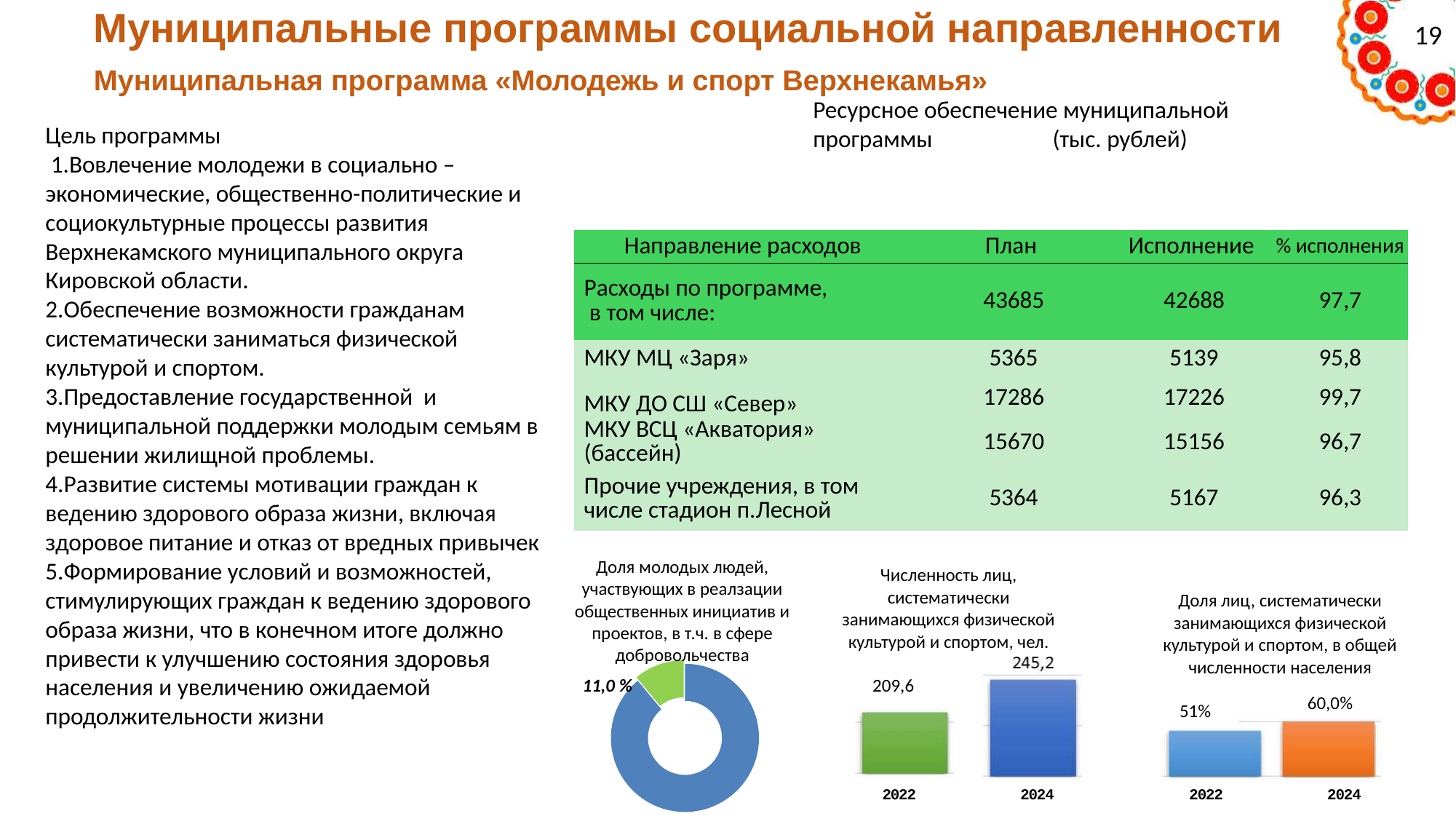
In the chart titled «Численность лиц, систематически занимающихся физической культурой и спортом, чел.», what is the value for 2022? 209,6 In the chart titled «Доля лиц, систематически занимающихся физической культурой и спортом, в общей численности населения», what is the value for 2024? 60,0% In the chart titled «Доля лиц, систематически занимающихся физической культурой и спортом, в общей численности населения», what is the value for 2022? 51% In the chart titled «Численность лиц, систематически занимающихся физической культурой и спортом, чел.», what is the value for 2024? 245,2 In the chart titled «Численность лиц, систематически занимающихся физической культурой и спортом, чел.», do the values rise or fall from 2022 to 2024? rise In the doughnut chart at the bottom left of the slide, what share is shown by the labelled green slice? 11,0 % In the chart titled «Доля лиц, систематически занимающихся физической культурой и спортом, в общей численности населения», which year has the lower value? 2022 In the chart titled «Доля лиц, систематически занимающихся физической культурой и спортом, в общей численности населения», how many years are shown? 2 What kind of chart is the one at the bottom left of the slide, titled «Доля молодых людей, участвующих в реализации общественных инициатив и проектов, в т.ч. в сфере добровольчества»? doughnut chart What kind of chart is the one titled «Численность лиц, систематически занимающихся физической культурой и спортом, чел.»? bar chart In the chart titled «Численность лиц, систематически занимающихся физической культурой и спортом, чел.», what is the difference between the 2024 and 2022 values? 35,6 In the chart titled «Численность лиц, систематически занимающихся физической культурой и спортом, чел.», which year has the higher value? 2024